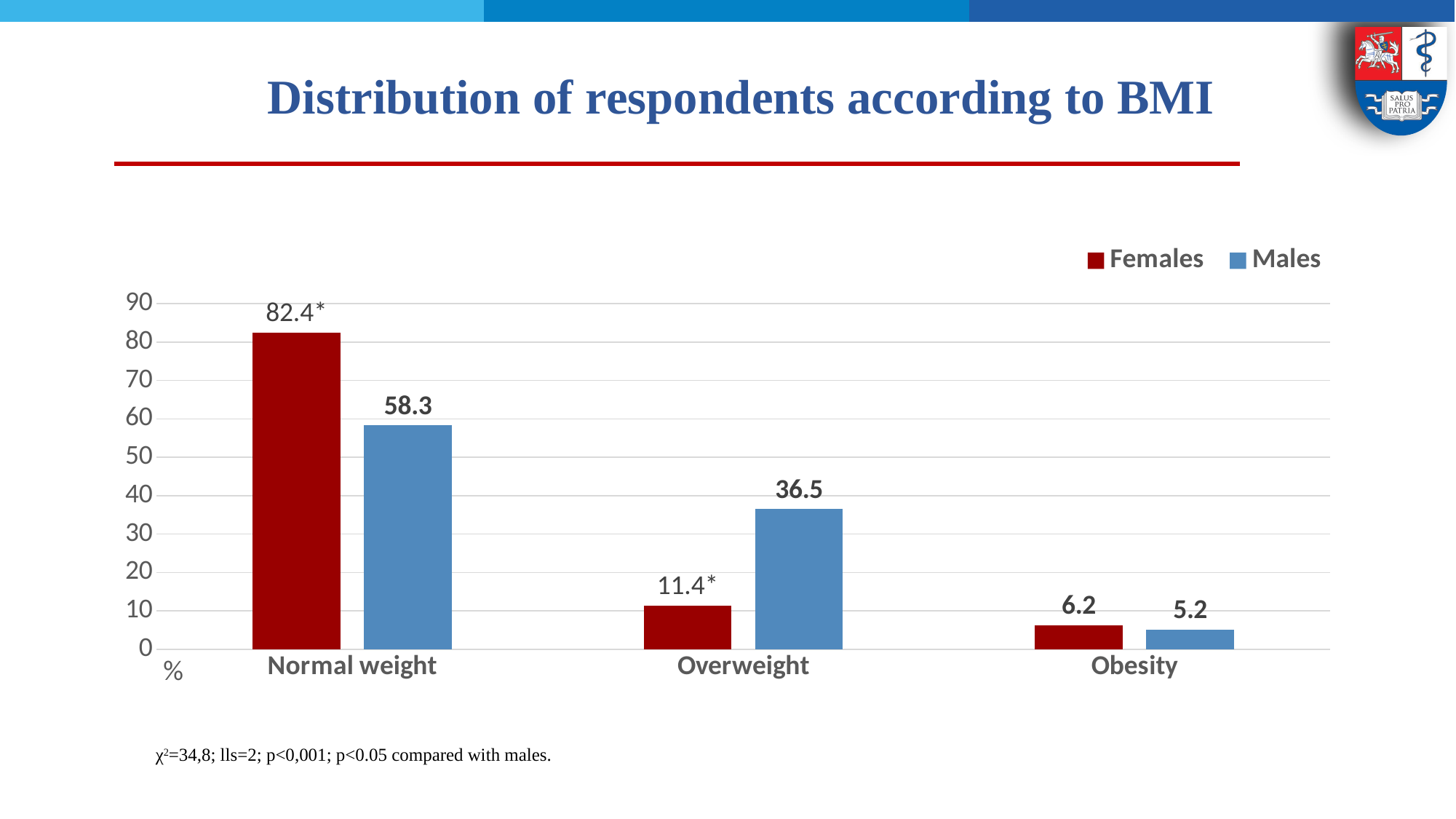
What is the difference between the Females and Males values in the Normal weight category? 24.1 What kind of chart is shown on the slide? Bar chart How many BMI categories are shown on the x axis? 3 What is the value for Females in the Normal weight category? 82.4 What is the value for Males in the Overweight category? 36.5 In the Overweight category, which series has the larger value, Females or Males? Males What is the title of the chart? Distribution of respondents according to BMI Which category has the lowest value for Females? Obesity Which category has the highest value for Males? Normal weight How many series does the legend list? 2 What is the difference between the Males and Females values in the Overweight category? 25.1 What is the value for Males in the Obesity category? 5.2